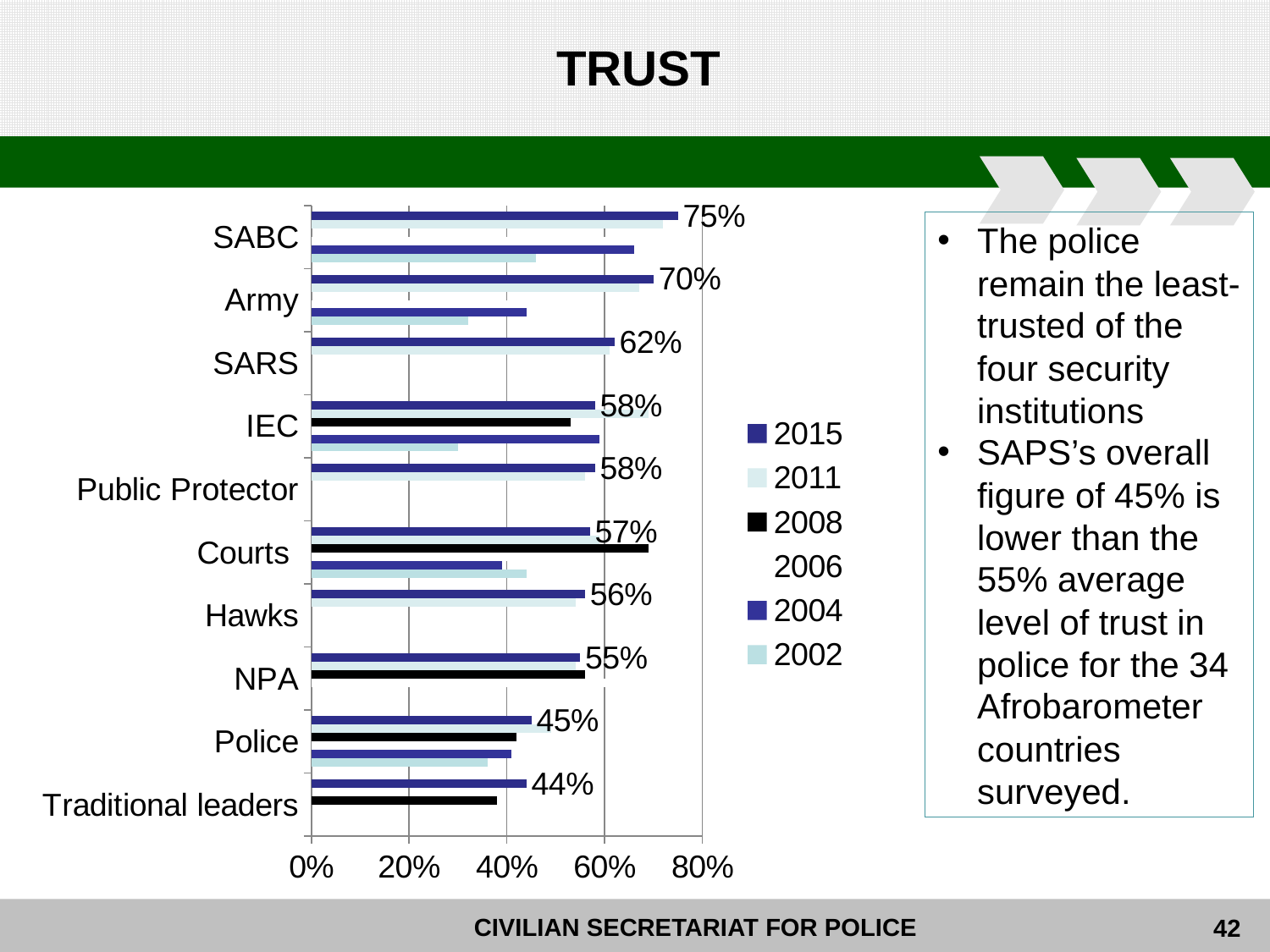
What is the 2015 trust value for SARS? 62% What is the difference between the 2015 trust values for SABC and the Police? 30% How many years does the legend list? 6 What is the 2015 trust value for the Police? 45% How many institutions are listed on the chart? 10 Is the 2002 value for the Army greater or less than 40%? less What type of chart is shown on the slide? Bar chart Which institution has the highest 2015 trust value? SABC What is the 2015 trust value for SABC? 75% What is the title of the slide containing the chart? TRUST Which institution has the lowest 2015 trust value? Traditional leaders Which has a higher 2015 trust value, the Army or the Courts? Army